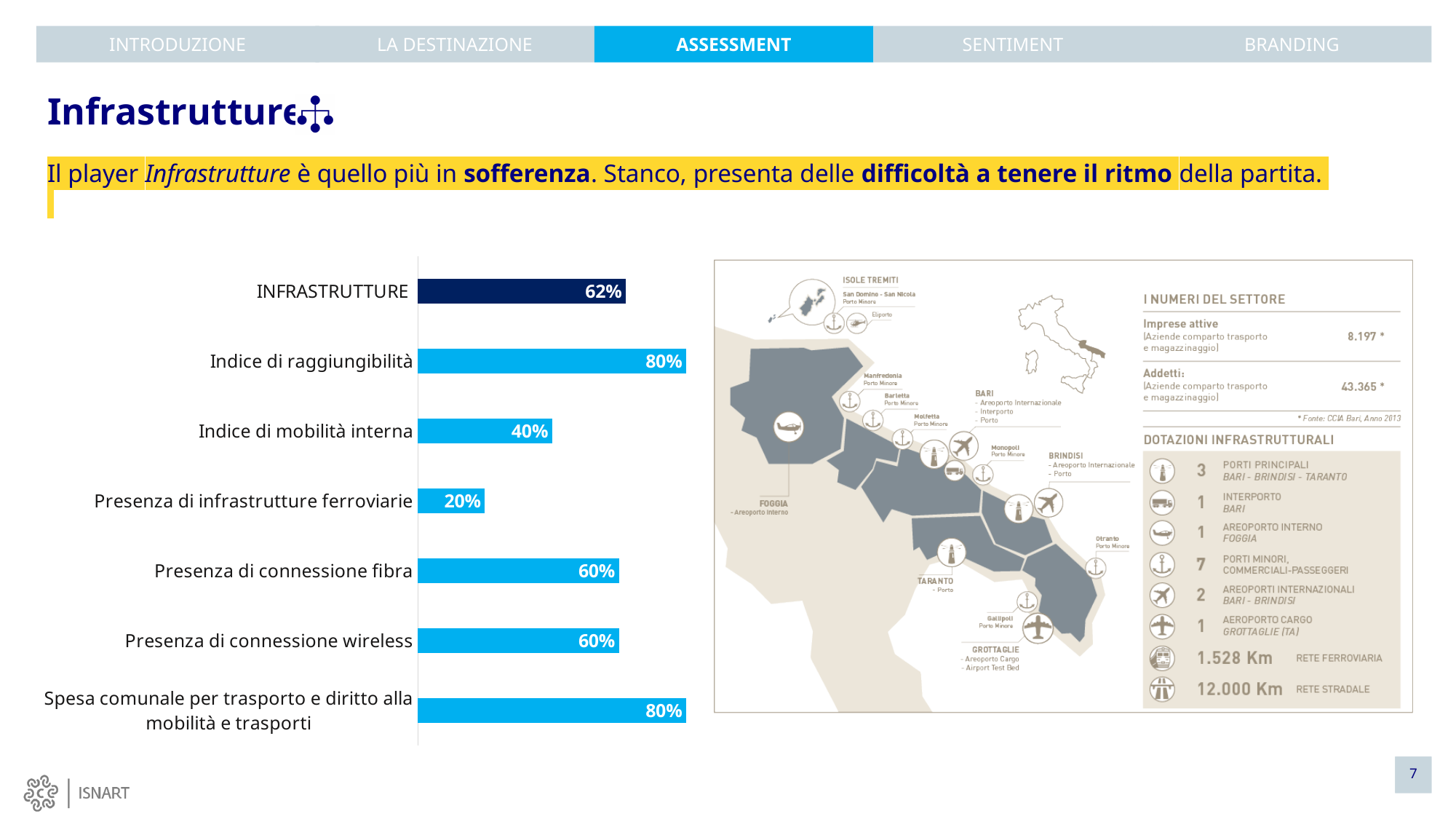
How many categories are shown in the bar chart? 7 What is the difference between the values for Indice di raggiungibilità and Indice di mobilità interna? 40% What is the difference between the values for INFRASTRUTTURE and Presenza di connessione fibra? 2% Which category has the lowest value in the bar chart? Presenza di infrastrutture ferroviarie What value is shown for INFRASTRUTTURE in the bar chart? 62% What value is shown for Indice di mobilità interna? 40% What value is shown for Presenza di infrastrutture ferroviarie? 20% Which bar in the chart is drawn in a darker blue than the others? INFRASTRUTTURE What kind of chart is shown on the left of the slide? Bar chart Which is larger, the value for Indice di mobilità interna or the value for Presenza di connessione fibra? Presenza di connessione fibra What value is shown for Indice di raggiungibilità? 80% What value is shown for Presenza di connessione wireless? 60%